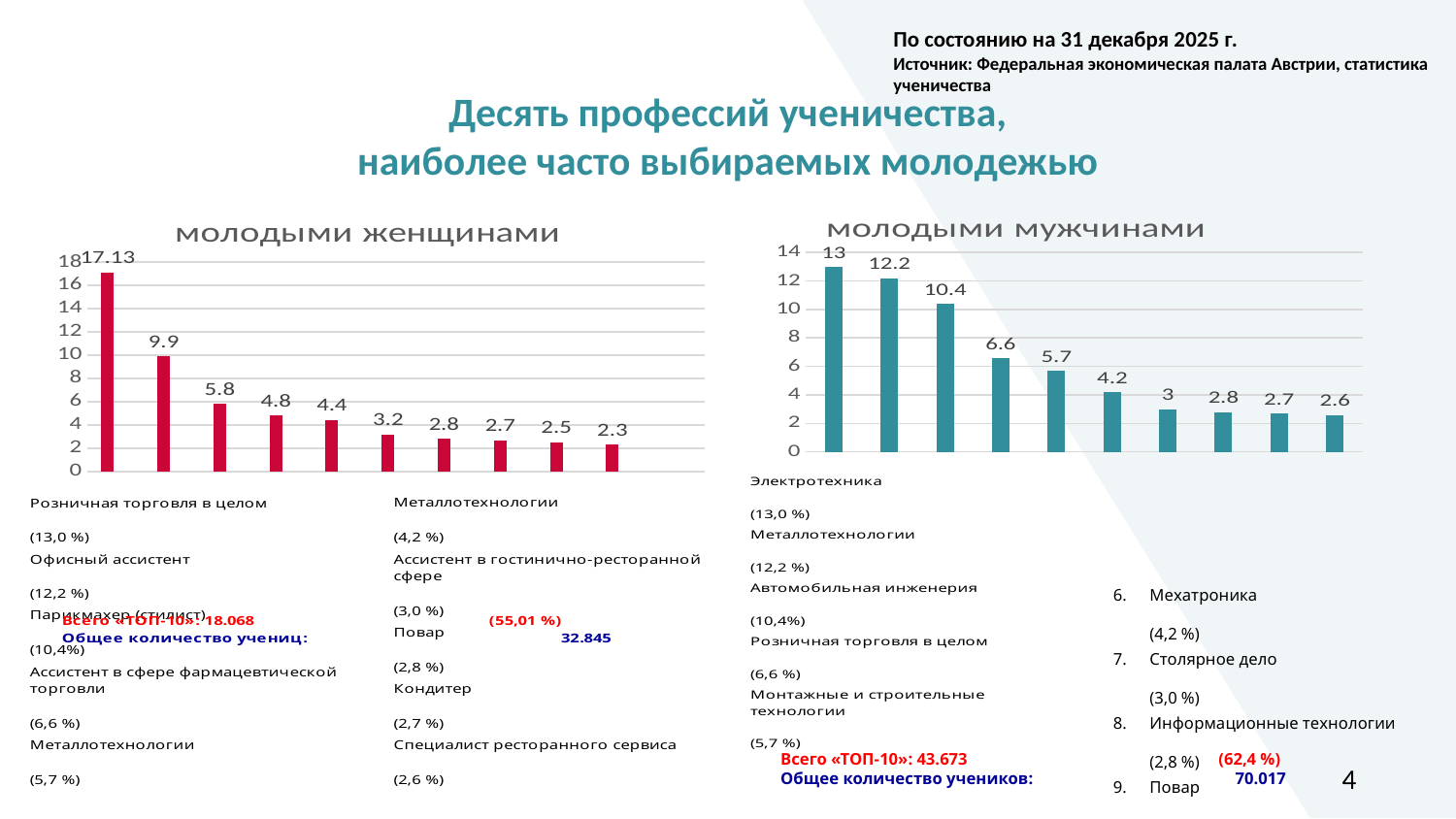
What kind of chart is the "молодыми женщинами" chart? bar chart In the "молодыми мужчинами" chart, what is the value of the third bar from the left? 10.4 In the "молодыми женщинами" chart, what is the difference between the first bar and the second bar? 7.23 How many bars are plotted in the "молодыми женщинами" chart? 10 Which chart has the taller first bar, "молодыми женщинами" or "молодыми мужчинами"? молодыми женщинами In the "молодыми мужчинами" chart, what is the value of the tallest bar? 13 In the "молодыми мужчинами" chart, what is the difference between the first bar and the second bar? 0.8 In the "молодыми женщинами" chart, what is the value of the shortest bar? 2.3 In the "молодыми мужчинами" chart, do the bar values rise or fall from left to right? fall In the "молодыми женщинами" chart, what is the value of the tallest bar? 17.13 How many bars are plotted in the "молодыми мужчинами" chart? 10 In the "молодыми мужчинами" chart, what is the value of the shortest bar? 2.6